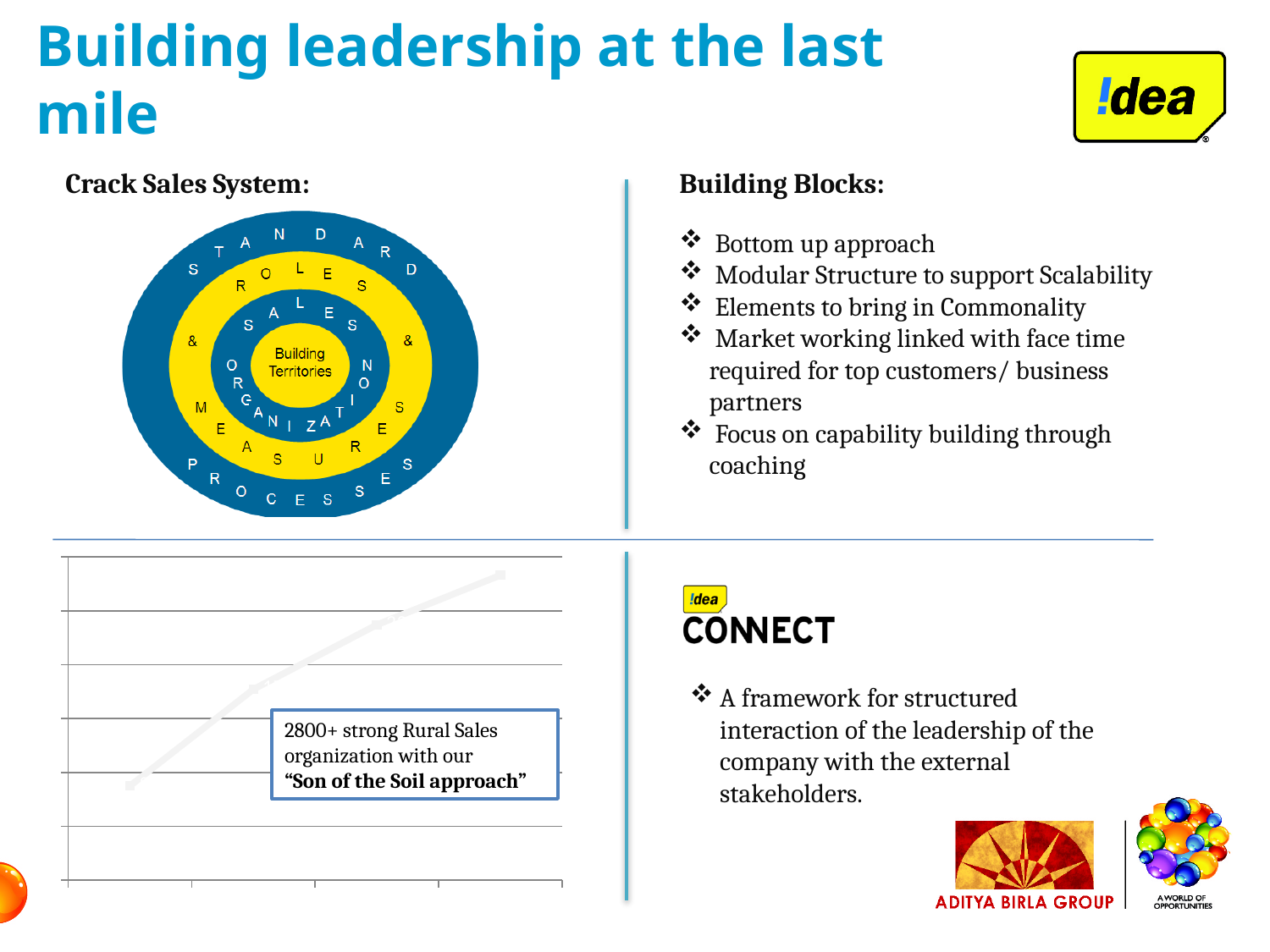
In the line chart at the bottom-left of the slide, do the values rise or fall from left to right along the x axis? rise How many lines are plotted in the line chart at the bottom-left of the slide? 1 What kind of chart is shown in the bottom-left of the slide? line chart